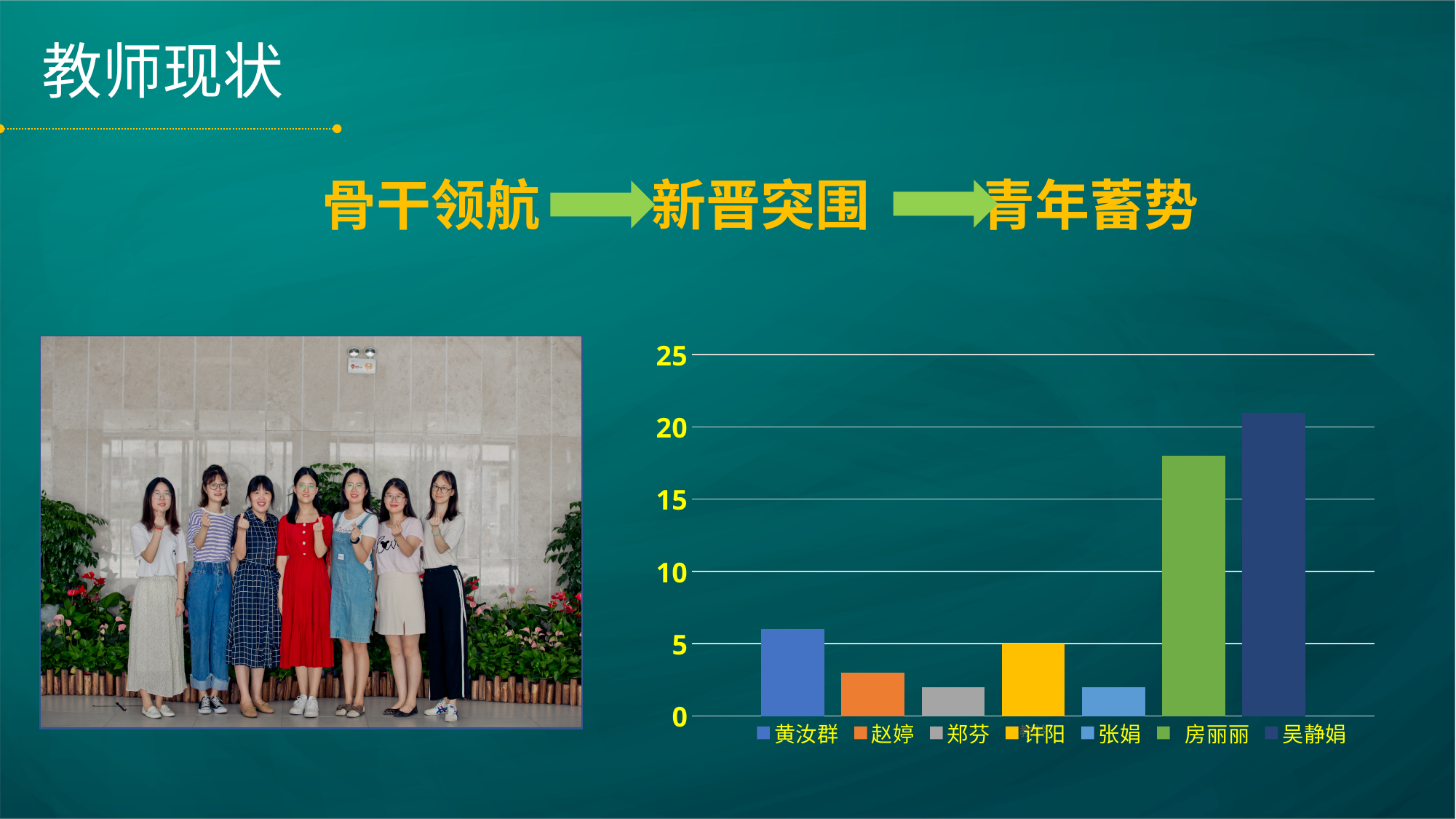
Which is larger, the value for 房丽丽 or the value for 黄汝群? 房丽丽 Which category has the highest bar in the chart? 吴静娟 Is the value for 郑芬 greater or less than 5? less What colour is the bar for 房丽丽? green Is the value for 黄汝群 greater or less than 5? greater How many entries does the chart legend list? 7 Is the value for 吴静娟 greater or less than 20? greater How many bars are plotted in the chart? 7 Which is larger, the value for 吴静娟 or the value for 房丽丽? 吴静娟 What type of chart is shown on the slide? bar chart